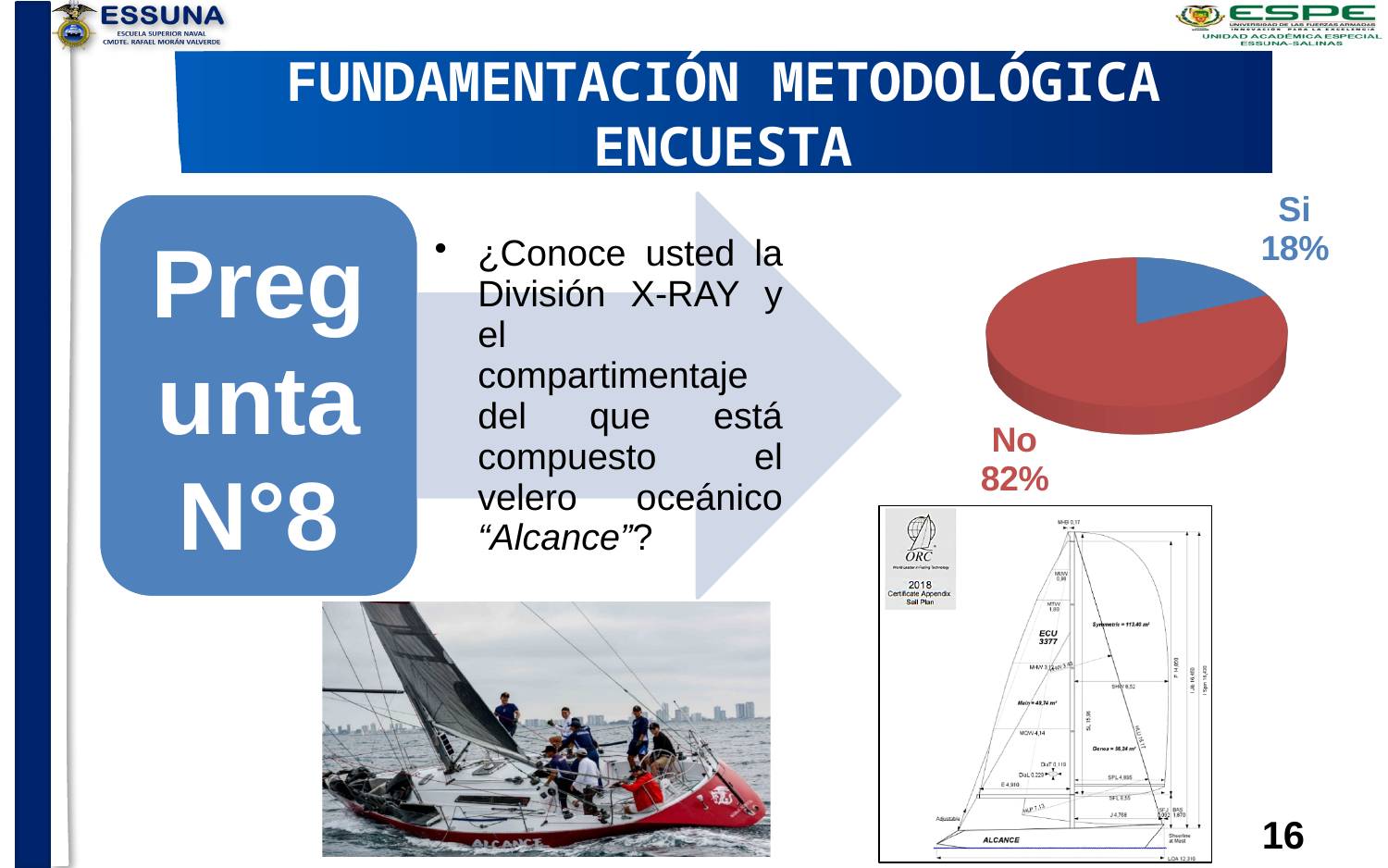
What kind of chart is shown on the slide? pie chart Which response has the smallest share of the pie? Si What colour is the "No" slice of the pie chart? red What is the difference in percentage points between the "No" and "Si" responses? 64 What percentage of respondents answered "No"? 82% What share of the pie does the "No" slice represent? 82% Which response has the largest share of the pie? No What colour is the "Si" slice of the pie chart? blue What percentage of respondents answered "Si"? 18% Which is larger, the share for "Si" or the share for "No"? No How many slices does the pie chart have? 2